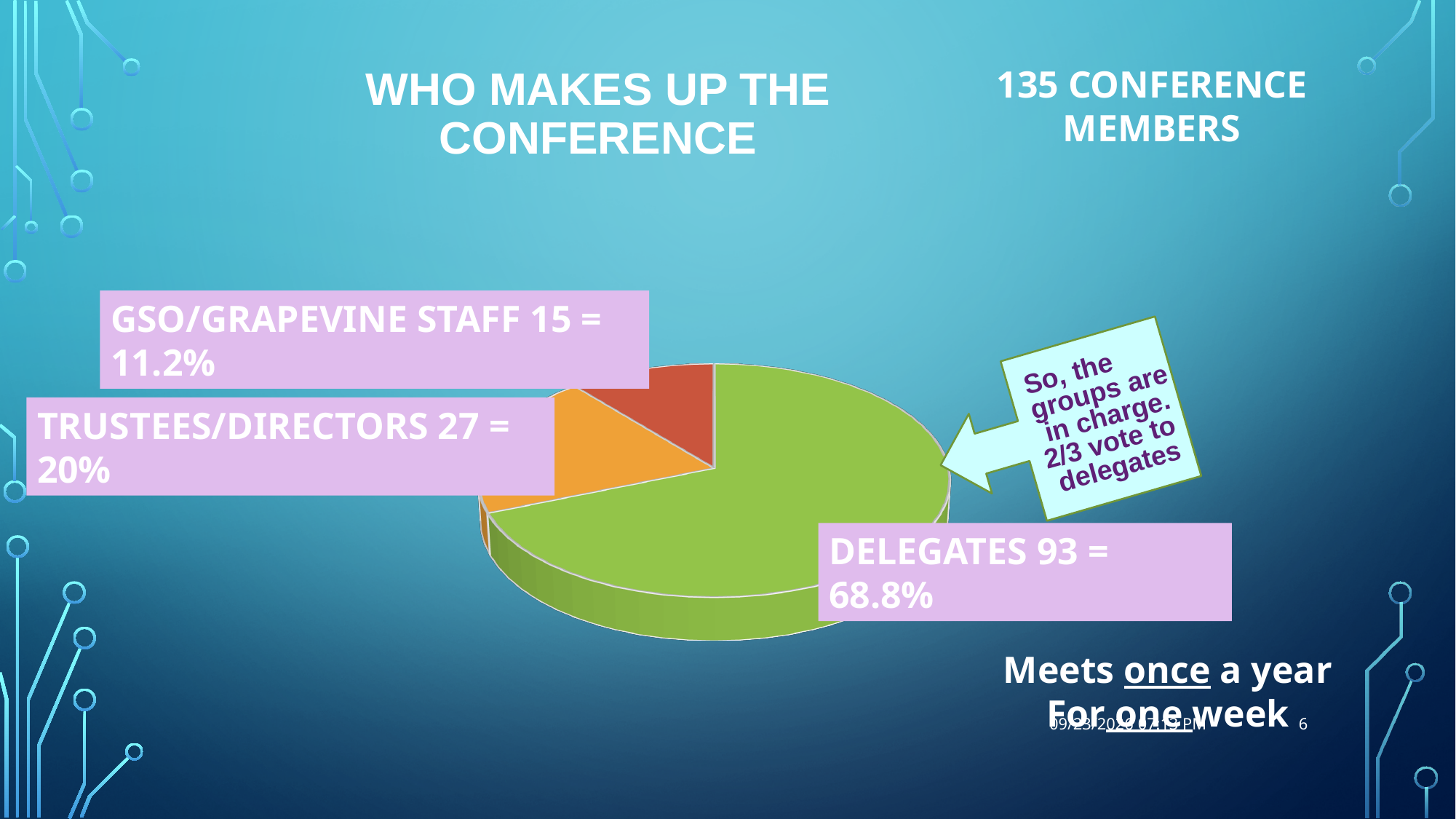
What share of the conference is made up of trustees/directors? 20% What percentage of the conference do delegates make up? 68.8% Which group makes up the smallest slice of the pie chart? GSO/Grapevine Staff What kind of chart is shown on the slide? Pie chart What colour is the delegates slice of the pie chart? Green How many delegates are in the conference according to the chart labels? 93 How many more delegates are there than trustees/directors? 66 How many trustees/directors are in the conference? 27 How many GSO/Grapevine staff are in the conference? 15 Which group makes up the largest slice of the pie chart? Delegates What share of the conference is GSO/Grapevine staff? 11.2% How many slices does the pie chart have? 3